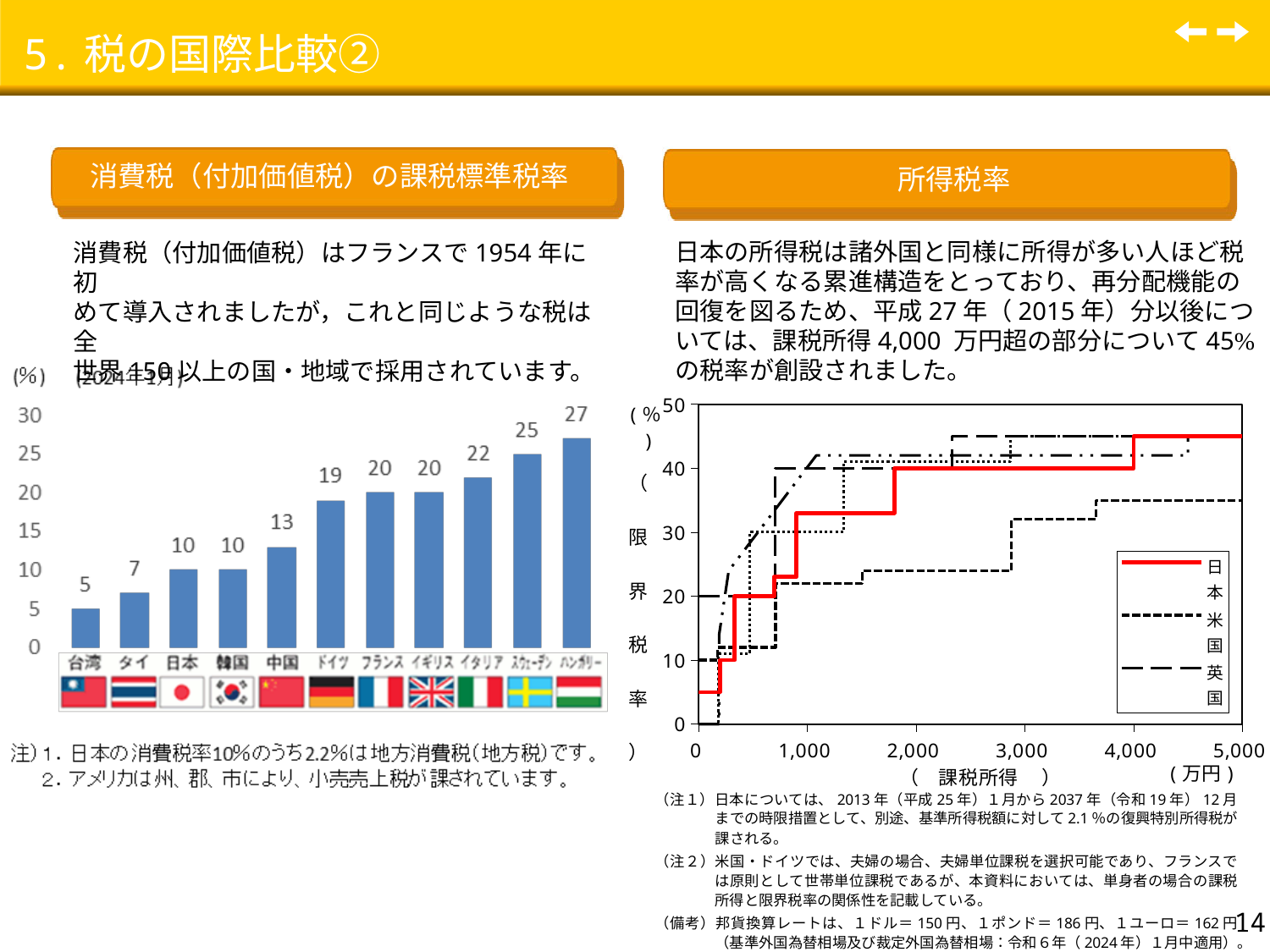
In the left bar chart of consumption tax rates, which is larger, the value for 中国 or the value for イタリア? イタリア In the left bar chart of consumption tax rates, what is the value for ドイツ? 19 In the left bar chart of consumption tax rates, do the values rise or fall from left to right? rise In the right chart of income tax rates, is the value for 米国 at 5,000 万円 greater or less than 40? less In the left bar chart of consumption tax rates, what is the value for 日本? 10 What kind of chart is the left chart of consumption tax rates? bar chart In the right chart of income tax rates, how many series does the legend list? 3 In the left bar chart of consumption tax rates, which country has the lowest rate? 台湾 In the left bar chart of consumption tax rates, how many countries or regions are shown? 11 In the right chart of income tax rates, is the value for 日本 at 5,000 万円 greater or less than 40? greater In the left bar chart of consumption tax rates, what is the difference between ハンガリー and 台湾? 22 In the left bar chart of consumption tax rates, which country has the highest rate? ハンガリー